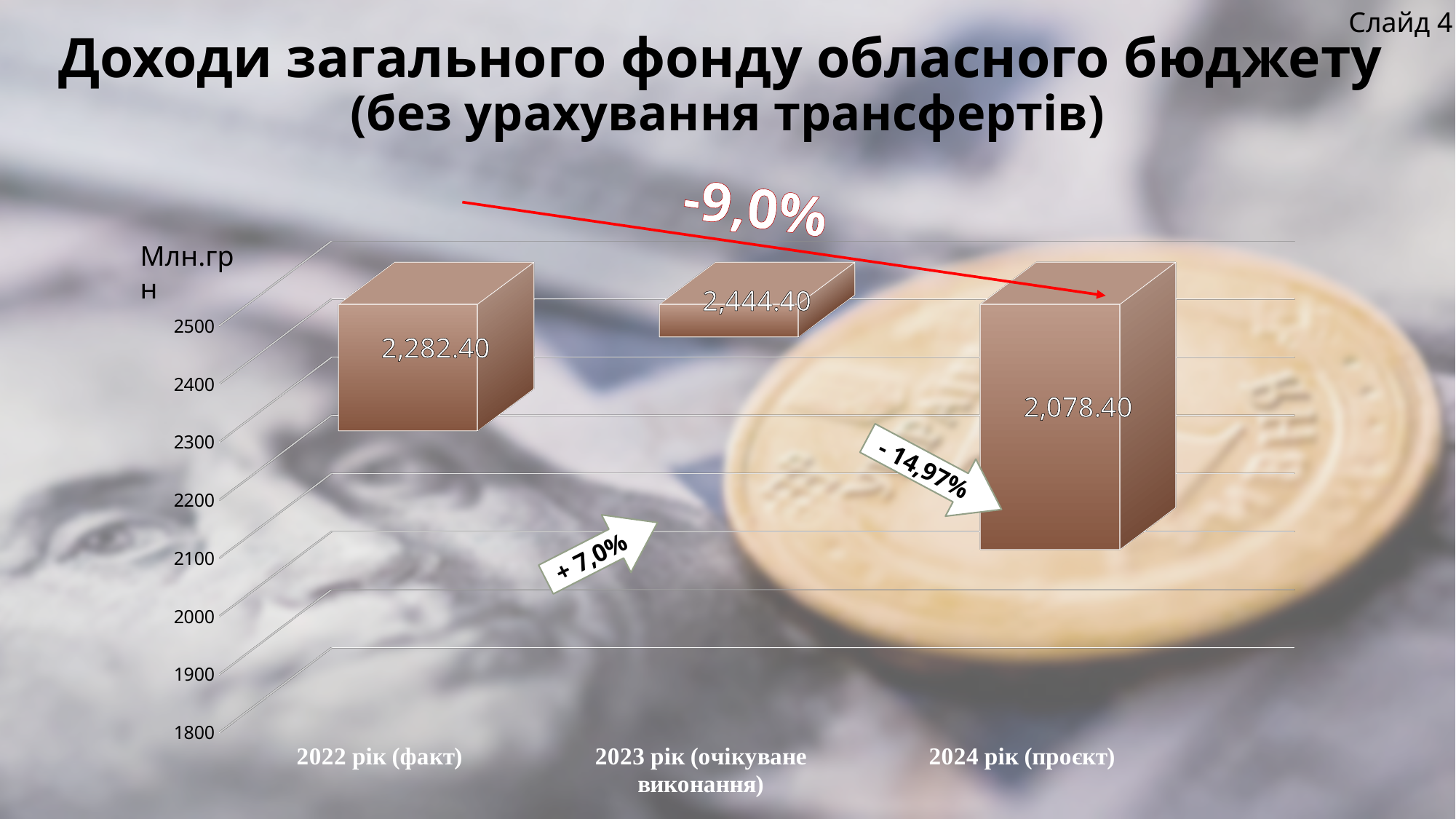
What is the value for 2022 рік (факт)? 2,282.40 How many categories are shown on the chart? 3 Which is larger, the value for 2022 рік (факт) or the value for 2024 рік (проєкт)? 2022 рік (факт) What is the difference between the values for 2022 рік (факт) and 2024 рік (проєкт)? 204.00 What is the difference between the values for 2023 рік (очікуване виконання) and 2022 рік (факт)? 162.00 What is the value for 2023 рік (очікуване виконання)? 2,444.40 What is the value for 2024 рік (проєкт)? 2,078.40 Which category has the highest value? 2023 рік (очікуване виконання) Which category has the lowest value? 2024 рік (проєкт) What kind of chart is shown on the slide? bar chart Is the value for 2024 рік (проєкт) greater or less than 2000? greater What unit label is shown on the vertical axis of the chart? Млн.грн